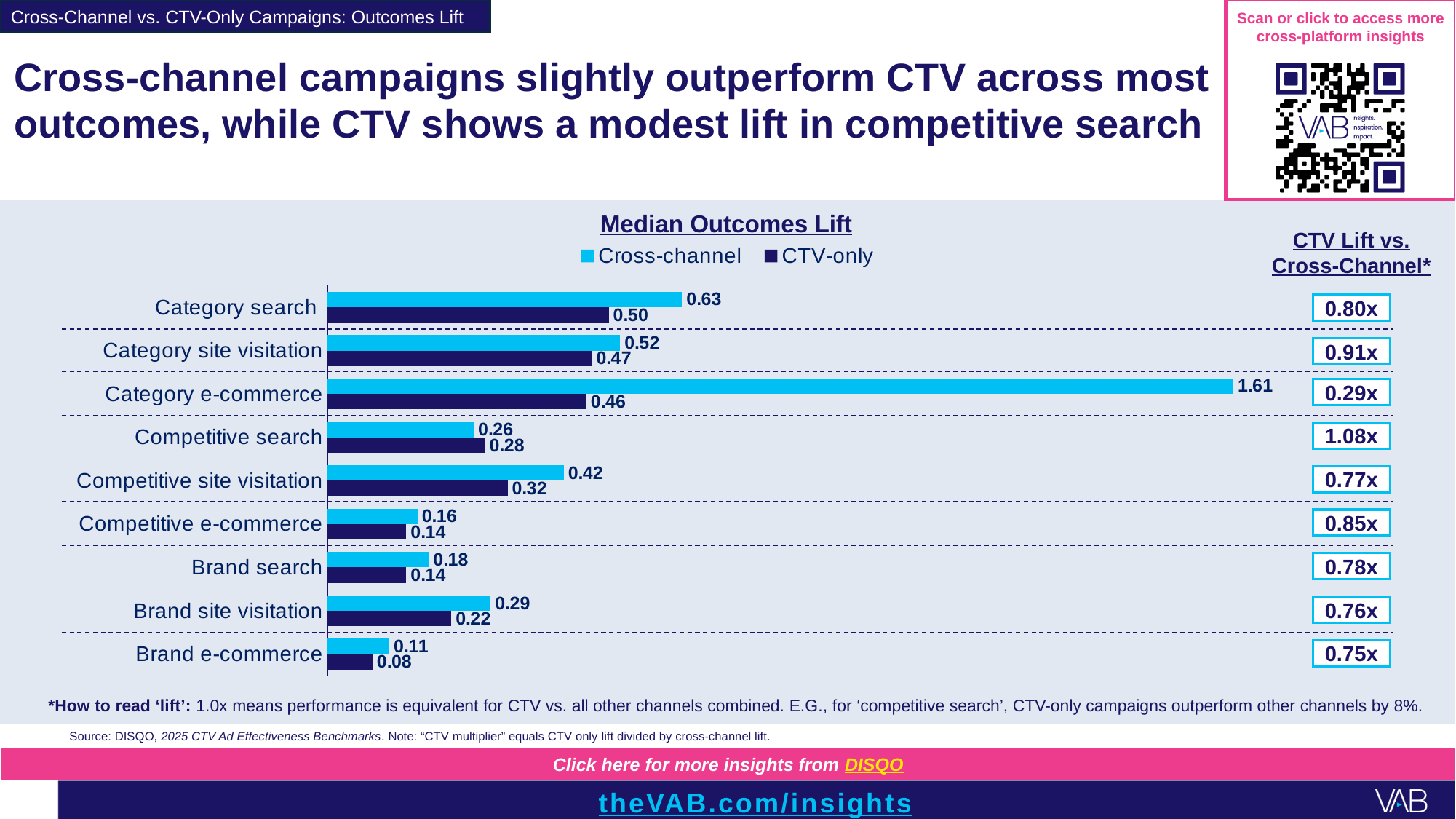
Which category has the highest Cross-channel lift? Category e-commerce What CTV Lift vs. Cross-Channel multiplier is shown for Competitive search? 1.08x What kind of chart is shown on the slide? Bar chart What is the Cross-channel value for Brand site visitation? 0.29 Which category has the lowest CTV-only lift? Brand e-commerce How many outcome categories are shown in the chart? 9 What is the difference between the Cross-channel and CTV-only values for Category search? 0.13 What is the Cross-channel median outcomes lift for Category e-commerce? 1.61 What is the title of the chart? Median Outcomes Lift For Competitive search, which is larger: the Cross-channel value or the CTV-only value? CTV-only How many series does the legend list? 2 What is the CTV-only median outcomes lift for Competitive search? 0.28